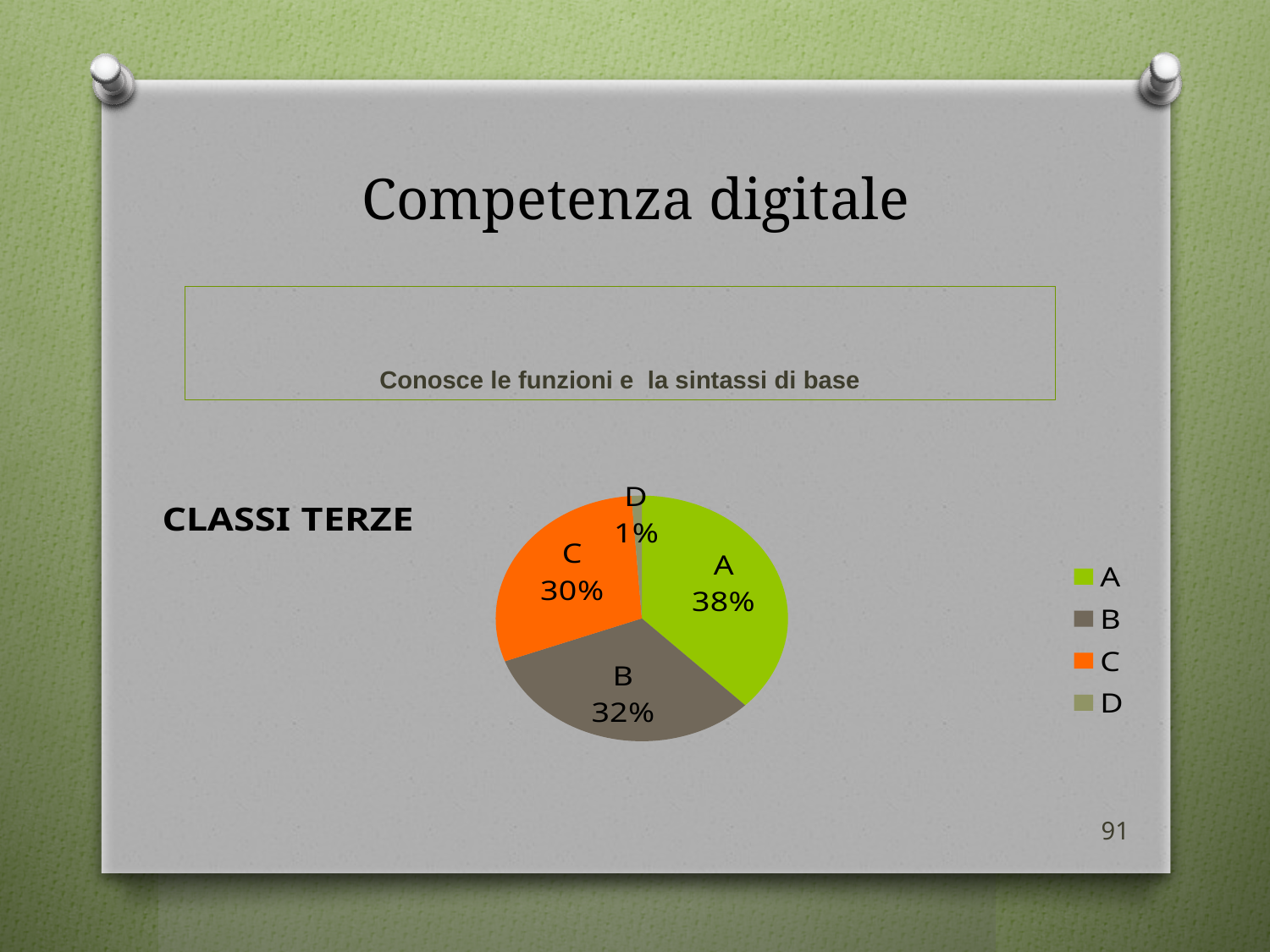
Which slice of the pie is the smallest? D What share of the pie does slice B represent? 32% What kind of chart is shown on the slide? pie chart Which slice of the pie is the largest? A What share of the pie does slice C represent? 30% What share of the pie does slice A represent? 38% Which is larger, slice B or slice C? B How many slices does the pie chart have? 4 What colour is slice C in the pie chart? orange How many entries does the legend list? 4 What is the difference in percentage points between slice A and slice C? 8%